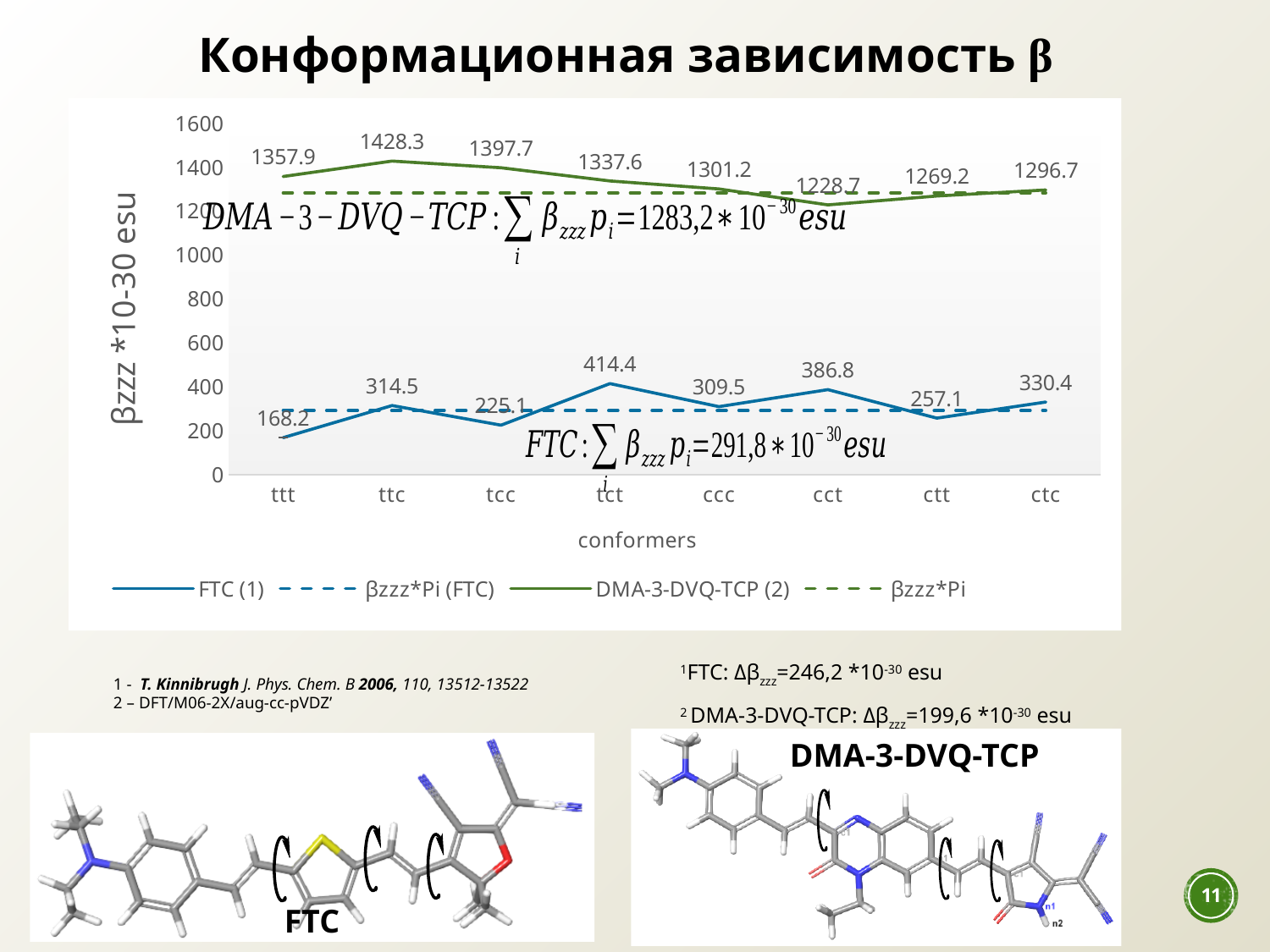
Which conformer has the lowest value in the DMA-3-DVQ-TCP (2) series? cct Which conformer has the highest value in the FTC (1) series? tct What is the difference between the highest and lowest values of the FTC (1) series? 246.2 What kind of chart is shown on the slide? line chart What is the difference between the DMA-3-DVQ-TCP (2) values for ttc and ttt? 70.4 Which conformer has the highest value in the DMA-3-DVQ-TCP (2) series? ttc What is the value of the FTC (1) series for the tct conformer? 414.4 How many conformers are shown on the x axis? 8 Which conformer has the lowest value in the FTC (1) series? ttt How many series does the legend list? 4 What is the value of the DMA-3-DVQ-TCP (2) series for the ttc conformer? 1428.3 In the FTC (1) series, which is larger: the value for ttc or the value for ccc? ttc